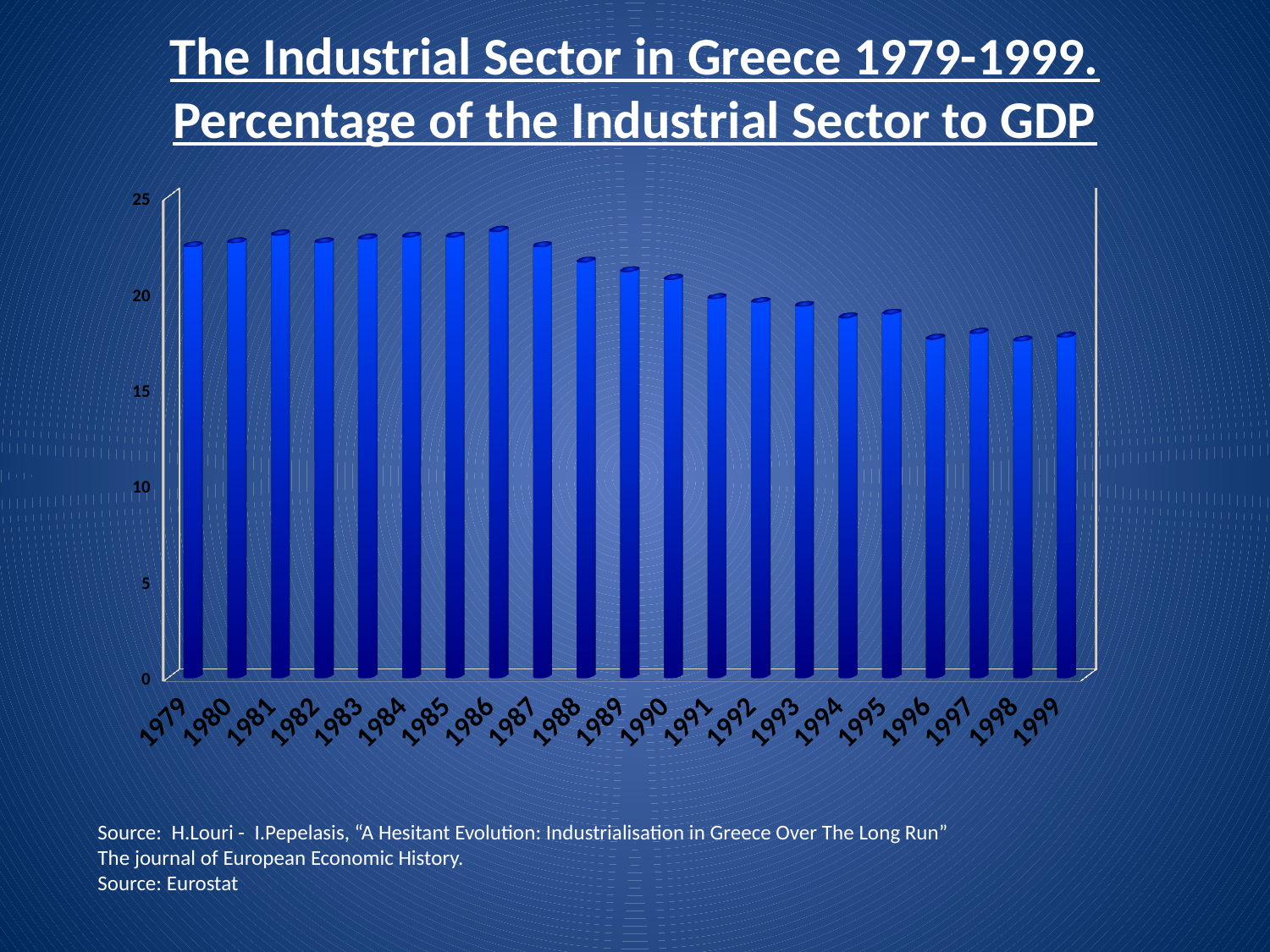
How many years (bars) are plotted in the chart? 21 Is the value for 1988 greater or less than 20? greater Is the value for 1996 greater or less than 20? less Overall, do the values rise or fall from 1979 to 1999? fall Which year has the larger value, 1981 or 1999? 1981 Is the value for 1999 greater or less than 20? less Which year has the larger value, 1979 or 1996? 1979 What kind of chart is shown on the slide? bar chart What is the highest value shown on the vertical axis of the chart? 25